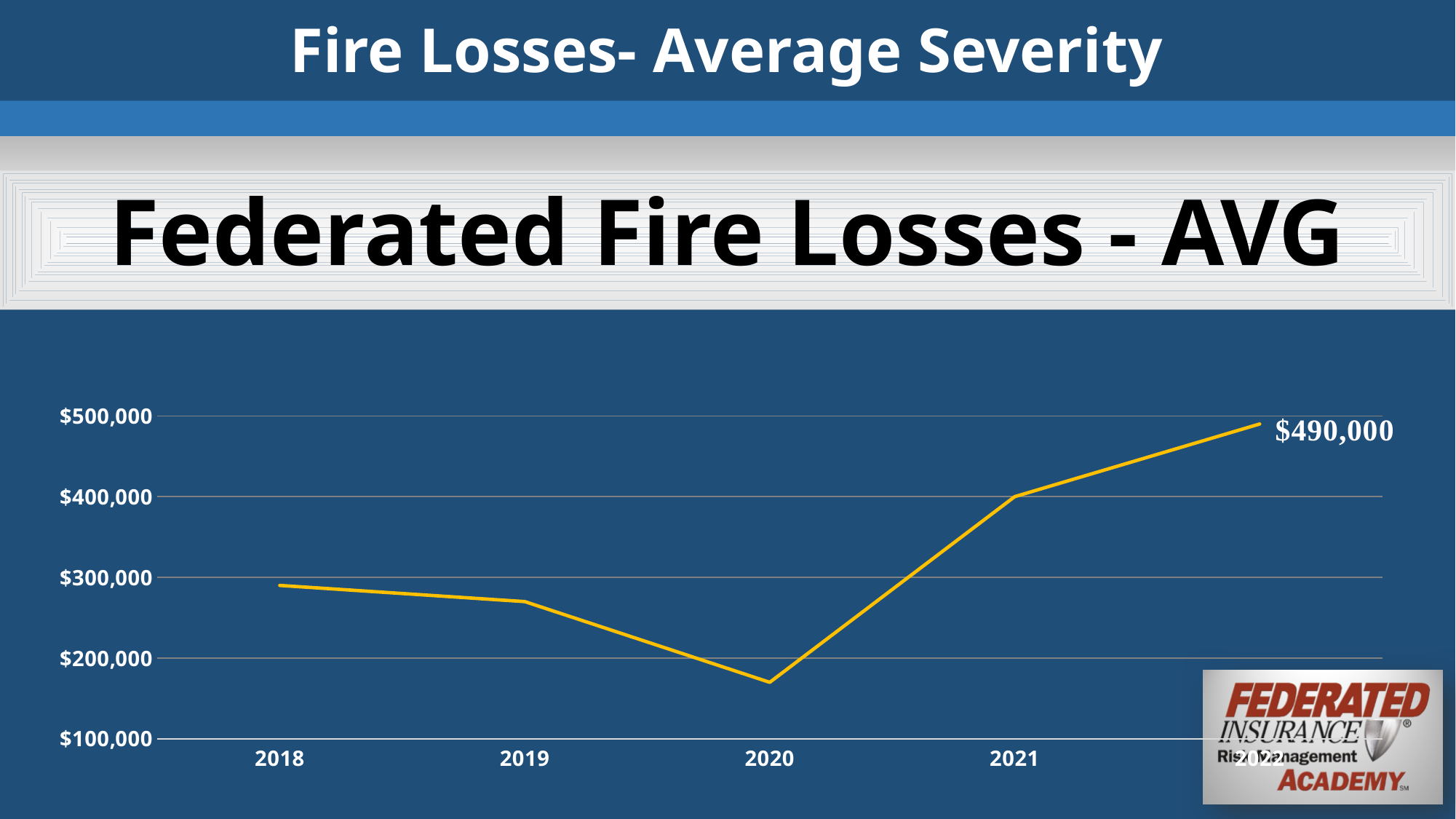
Is the value for 2019 greater or less than $300,000? less Do the values rise or fall from 2020 to 2022? rise Which year has the lowest average fire loss? 2020 How many years are plotted on the x axis? 5 Which year has the larger average fire loss, 2019 or 2021? 2021 What is the title of the chart? Federated Fire Losses - AVG Is the value for 2020 greater or less than $200,000? less Is the value for 2021 greater or less than $300,000? greater Do the values rise or fall from 2018 to 2020? fall Which year has the highest average fire loss? 2022 What is the average fire loss value shown for 2022? $490,000 What kind of chart is shown on the slide? line chart